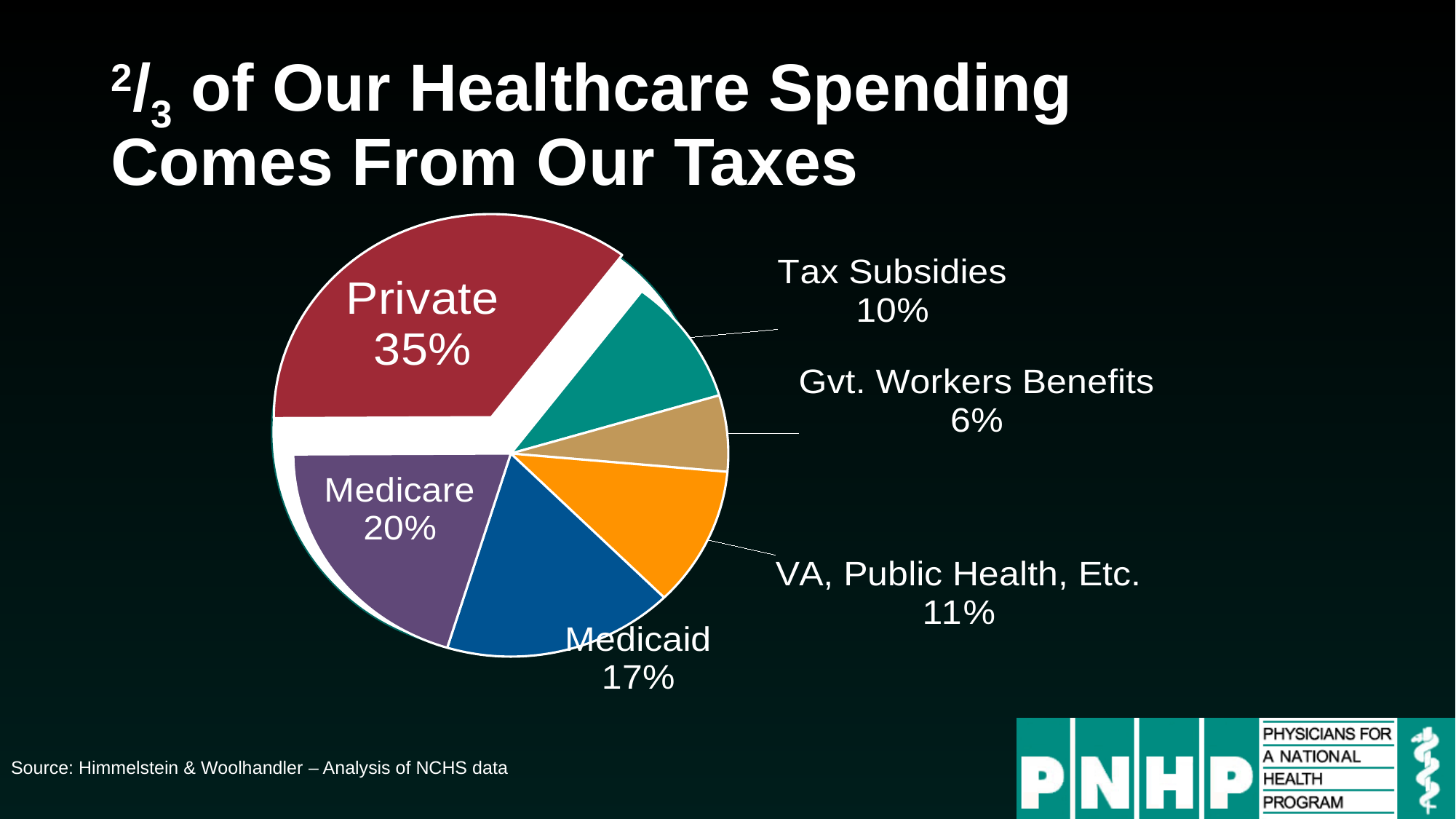
What percentage is shown for VA, Public Health, Etc.? 11% What percentage is shown for Gvt. Workers Benefits? 6% What percentage is shown for Tax Subsidies? 10% What is the difference in percentage points between Private and Medicare? 15 How many slices does the pie chart have? 6 What kind of chart is shown on the slide? Pie chart What percentage is shown for Medicaid? 17% Which slice of the pie is the largest? Private Which is larger, Medicaid or VA, Public Health, Etc.? Medicaid What percentage is shown for Medicare? 20% What share of healthcare spending is labelled as Private? 35% Which slice of the pie is the smallest? Gvt. Workers Benefits